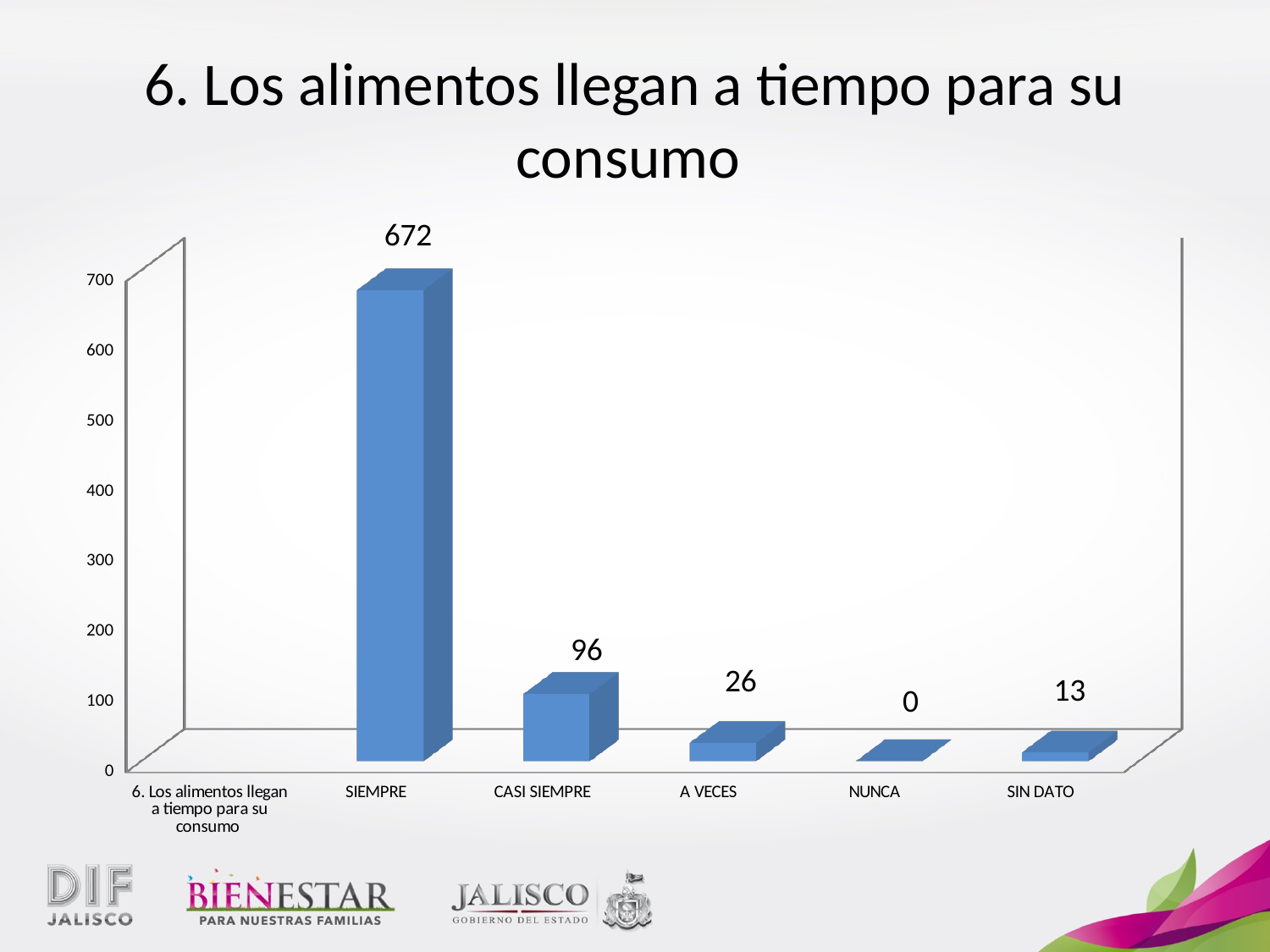
What is the value for SIEMPRE? 672 What is the value for SIN DATO? 13 What is the value for NUNCA? 0 What is the value for CASI SIEMPRE? 96 Which category has the lowest value? NUNCA What kind of chart is shown on the slide? bar chart Which category has the highest value? SIEMPRE What is the value for A VECES? 26 Is the value for CASI SIEMPRE greater or less than 200? less What is the title of the chart? 6. Los alimentos llegan a tiempo para su consumo What is the difference between the values for SIEMPRE and CASI SIEMPRE? 576 Which is larger, the value for A VECES or the value for SIN DATO? A VECES